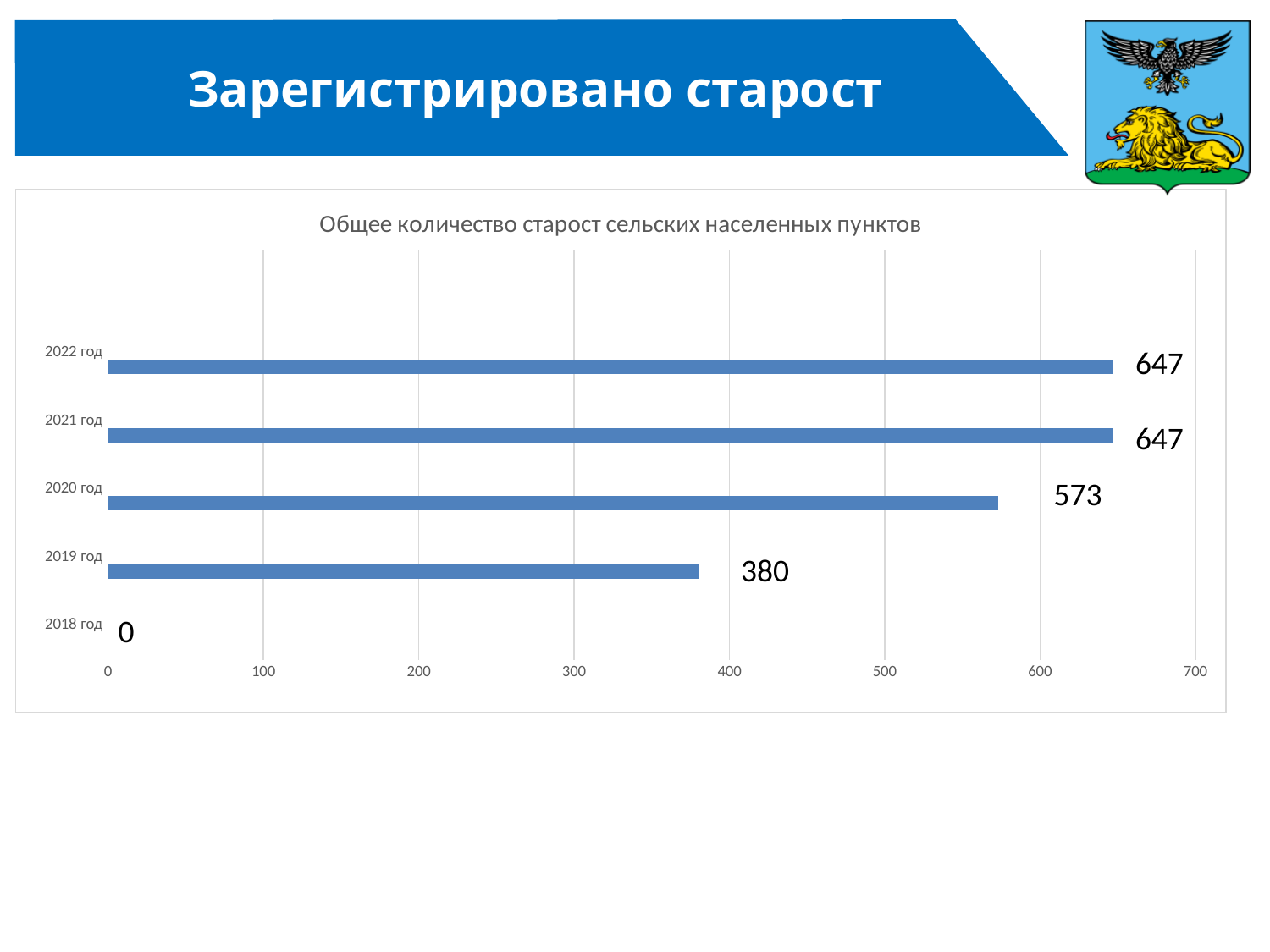
What is the difference between the values for 2020 год and 2019 год? 193 Which year has the lowest value? 2018 год What is the value for 2018 год? 0 Is the value for 2019 год greater or less than 400? less Which is larger, the value for 2020 год or the value for 2019 год? 2020 год What is the value for 2022 год? 647 How many years are shown on the chart? 5 What is the value for 2019 год? 380 What is the title of the chart? Общее количество старост сельских населенных пунктов What kind of chart is shown on the slide? bar chart What is the value for 2020 год? 573 What is the difference between the values for 2021 год and 2020 год? 74